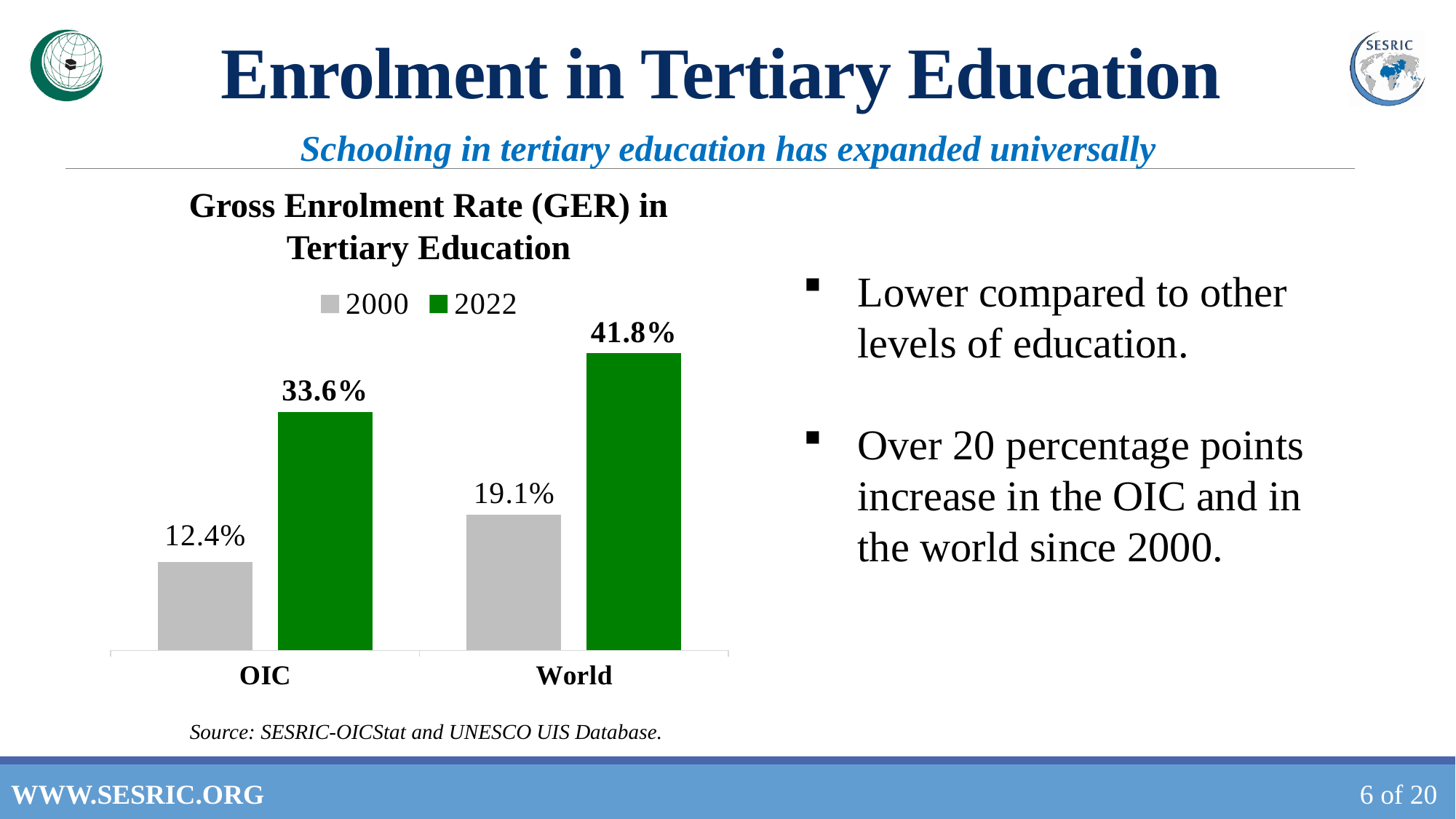
What is the Gross Enrolment Rate in tertiary education for OIC in 2022? 33.6% How many series does the chart legend list? 2 Which bar in the chart has the lowest value? OIC, 2000 What type of chart is shown on the slide? Bar chart What is the Gross Enrolment Rate in tertiary education for the World in 2000? 19.1% What is the difference between the World and OIC Gross Enrolment Rates in 2022? 8.2 percentage points Which is larger, the OIC rate in 2022 or the World rate in 2000? OIC rate in 2022 Which bar in the chart has the highest value? World, 2022 By how many percentage points did the OIC Gross Enrolment Rate increase from 2000 to 2022? 21.2 percentage points What is the Gross Enrolment Rate in tertiary education for OIC in 2000? 12.4% What is the Gross Enrolment Rate in tertiary education for the World in 2022? 41.8% How many categories are shown on the x axis of the chart? 2